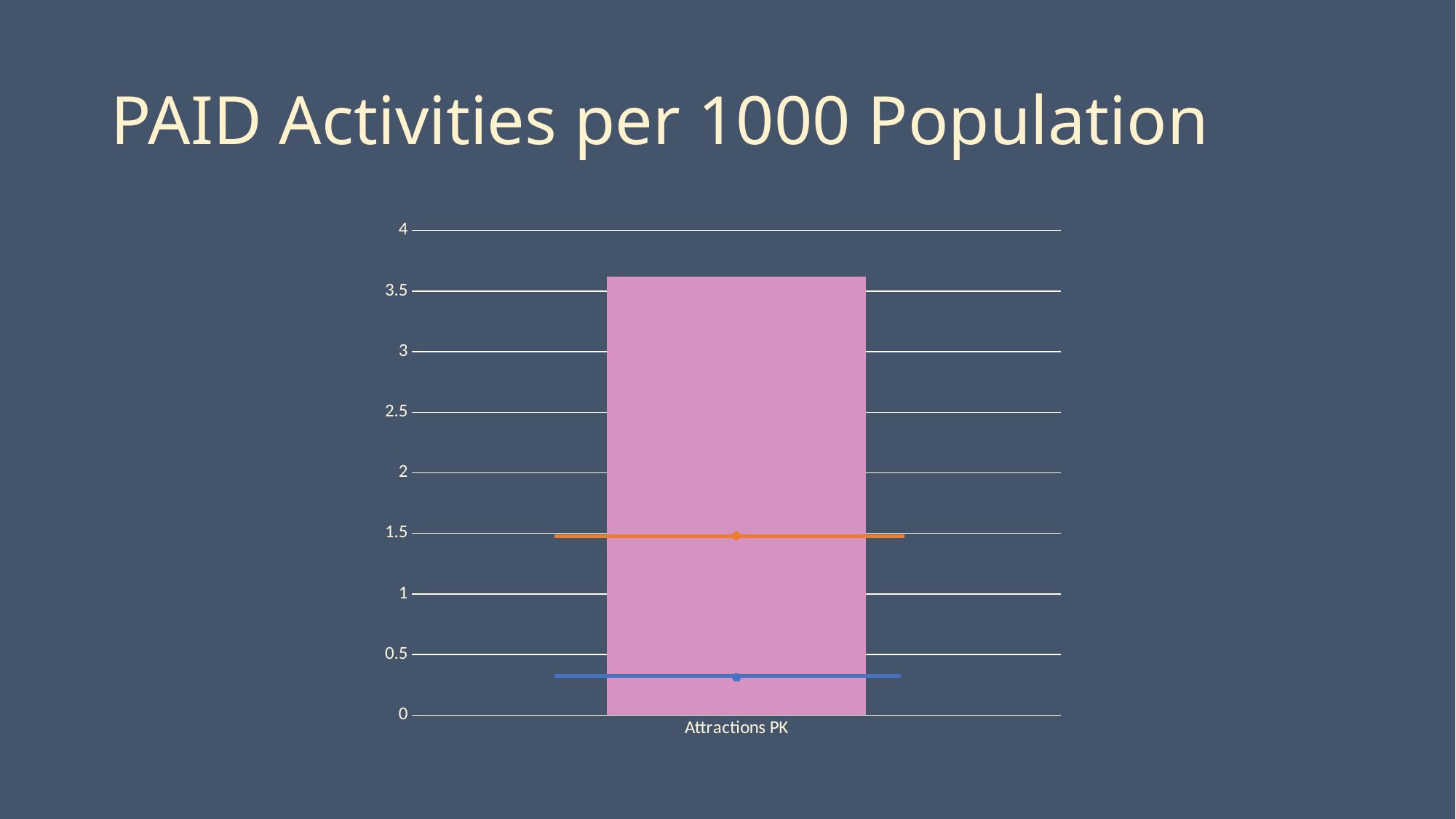
Is the value of the pink bar for Attractions PK greater or less than 4? less Is the value of the pink bar for Attractions PK greater or less than 3? greater Is the value marked by the blue line greater or less than 0.5? less How many categories are shown on the x axis of the chart? 1 Which is higher: the pink bar for Attractions PK or the orange line? the pink bar What kind of chart is shown on the slide? bar chart What is the label of the single category on the x axis? Attractions PK Which is higher: the orange line or the blue line? the orange line What is the title of the slide's chart? PAID Activities per 1000 Population What is the maximum value shown on the y axis? 4